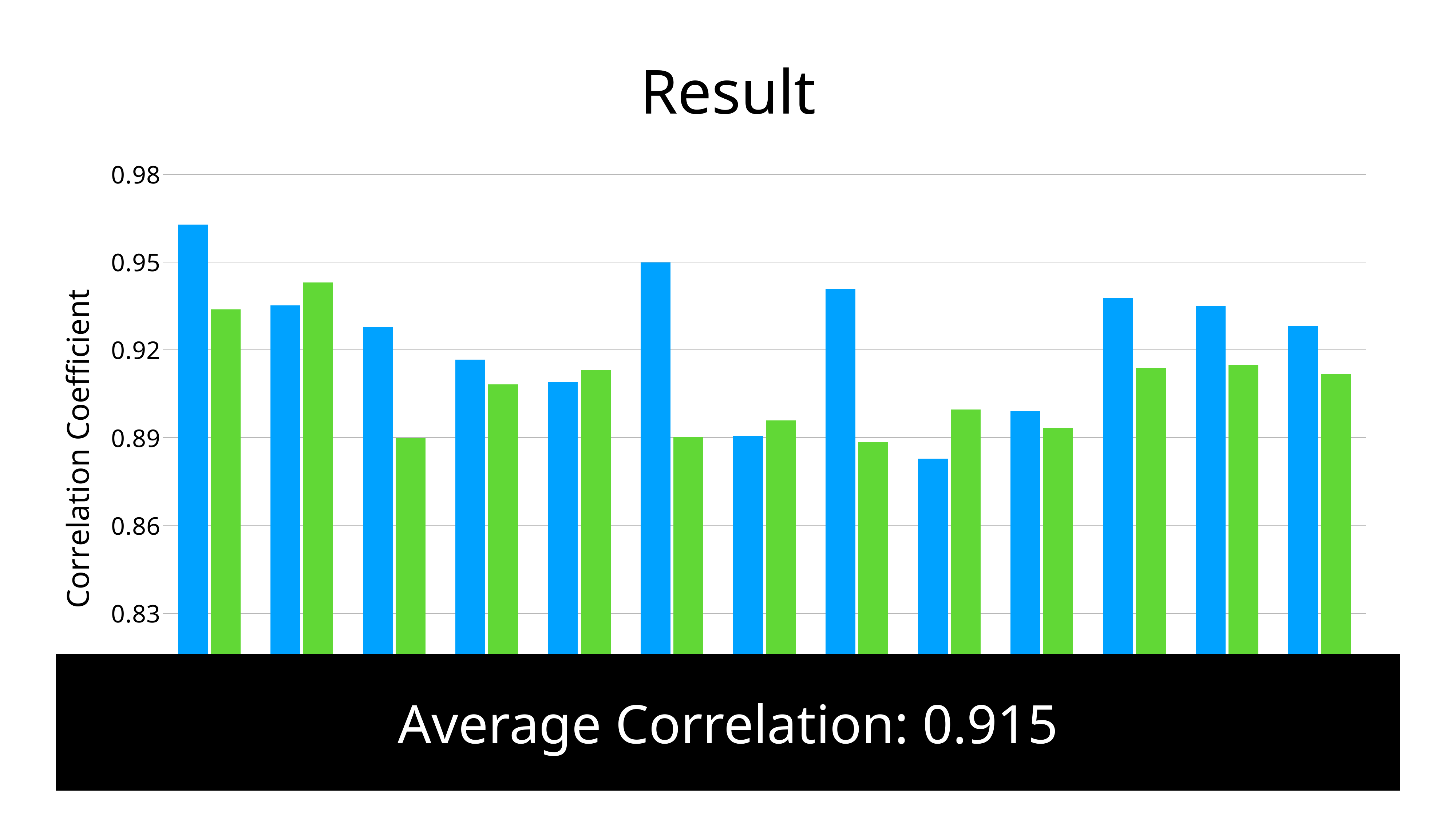
What is the title of the chart? Result Is the value of the blue bar in the ninth group from the left greater or less than 0.89? less Is the value of the leftmost blue bar greater or less than 0.95? greater Is the value of the blue bar in the sixth group from the left greater or less than 0.92? greater How many groups of bars (categories) are plotted in the chart? 13 Which bar in the chart is the shortest? the blue bar in the ninth group from the left What kind of chart is shown on the slide? bar chart What is the label on the vertical axis of the chart? Correlation Coefficient In the first (leftmost) group, which bar is taller, the blue one or the green one? blue Which bar in the chart is the tallest? the blue bar in the first (leftmost) group In the second group from the left, which bar is taller, the blue one or the green one? green